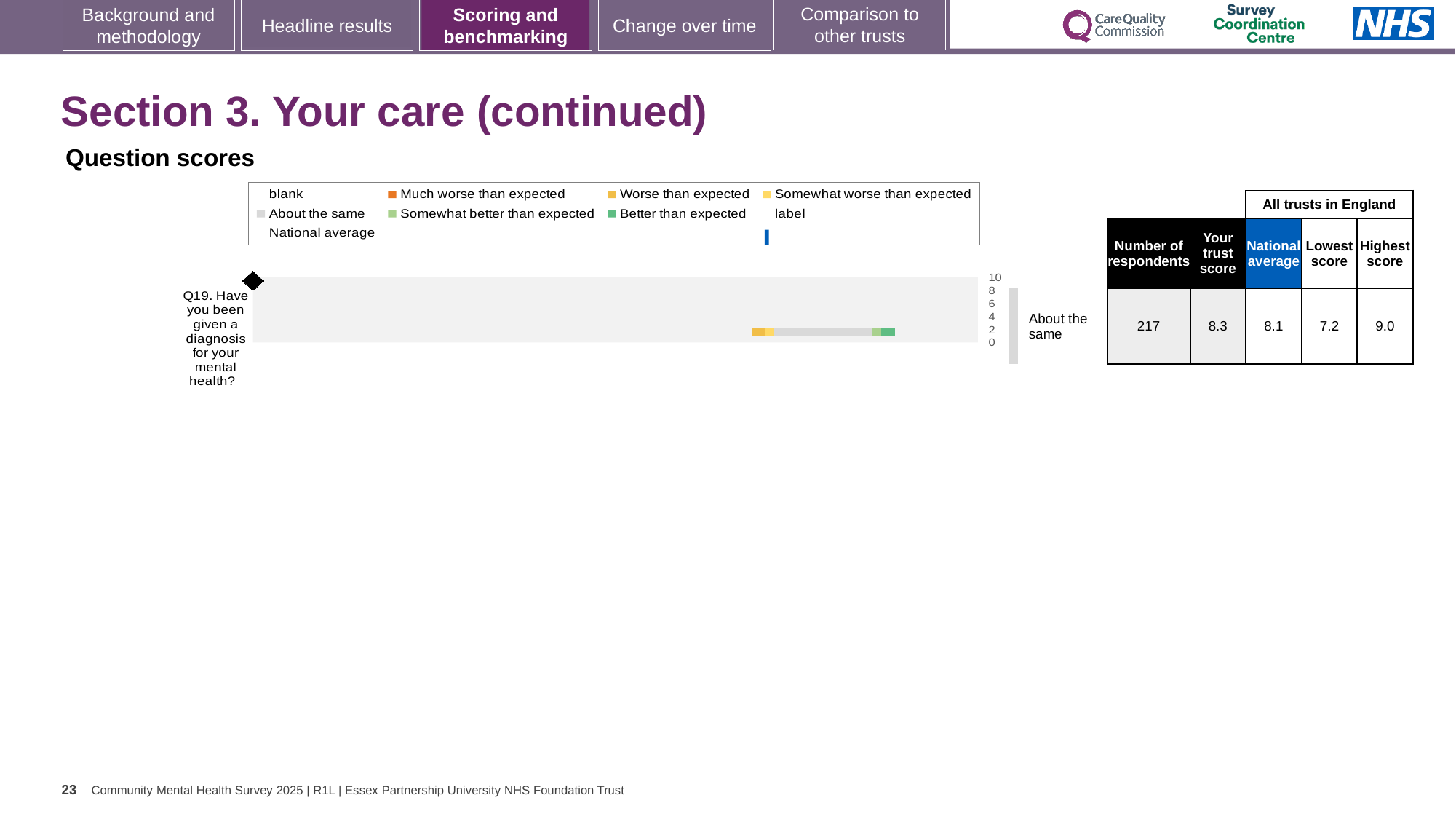
What is the highest score among all trusts in England for Q19? 9.0 What kind of chart is used to show the Q19 question score? bar chart What benchmark category is shown next to the bar for Q19? About the same Which is larger for Q19, the trust score or the national average? the trust score What is the lowest score among all trusts in England for Q19? 7.2 Is the trust score for Q19 greater or less than 8 on the chart's axis? greater How many survey questions are plotted in the chart? 1 What is the national average for Q19? 8.1 What is the number of respondents for Q19? 217 What is the trust score for Q19? 8.3 Which question is plotted in the chart? Q19. Have you been given a diagnosis for your mental health? What is the difference between the highest and lowest scores for Q19? 1.8